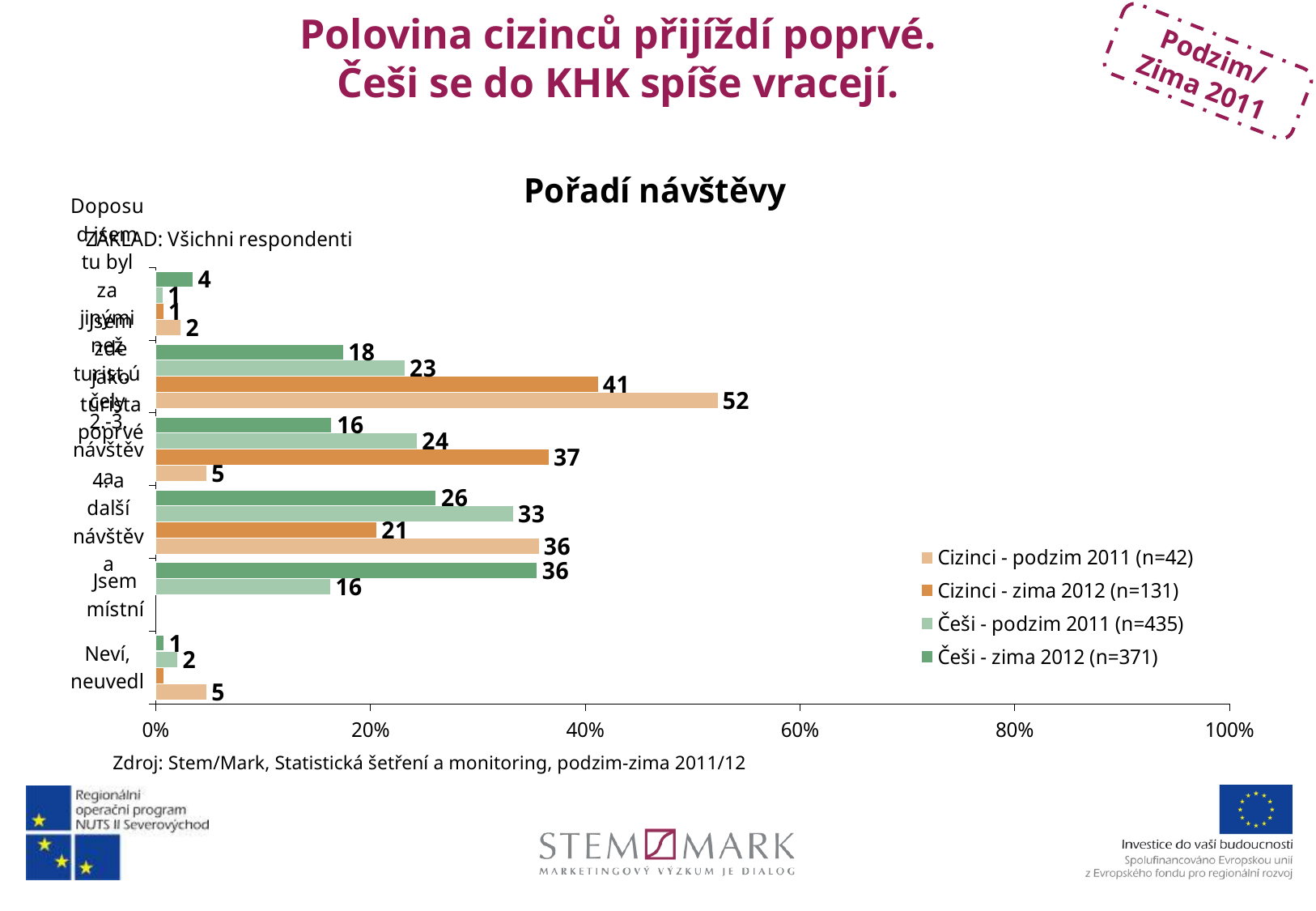
Is the highest value for 'Cizinci - podzim 2011 (n=42)' greater or less than 40%? greater How many series does the legend of the 'Pořadí návštěvy' chart list? 4 What is the sample size (n) given in the legend for 'Češi - podzim 2011'? 435 What is the value for 'Češi - podzim 2011 (n=435)' in the 'Neví, neuvedl' category? 2 What is the difference between 'Češi - zima 2012 (n=371)' and 'Češi - podzim 2011 (n=435)' in the 'Jsem místní' category? 20 What is the value for 'Cizinci - podzim 2011 (n=42)' in the 'Neví, neuvedl' category? 5 What is the value for 'Češi - zima 2012 (n=371)' in the 'Jsem místní' category? 36 What is the title of the chart? Pořadí návštěvy What is the value for 'Češi - podzim 2011 (n=435)' in the 'Jsem místní' category? 16 What kind of chart is shown on the slide? bar chart What is the highest value shown for the 'Cizinci - podzim 2011 (n=42)' series? 52 In the 'Jsem místní' category, which is larger: 'Češi - zima 2012 (n=371)' or 'Češi - podzim 2011 (n=435)'? Češi - zima 2012 (n=371)